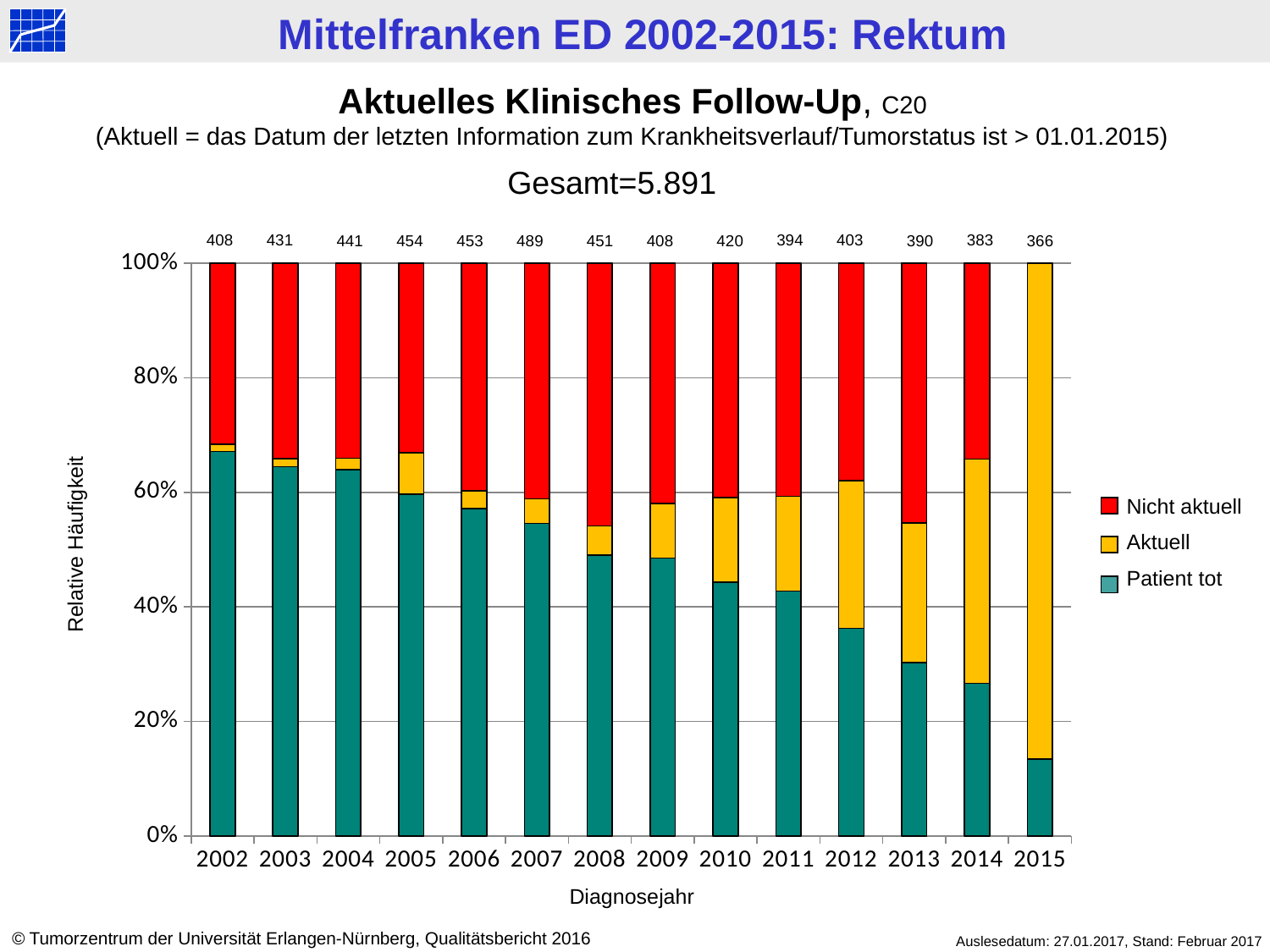
Which diagnosis year has the lowest number printed above its bar? 2015 Which diagnosis year has the highest number printed above its bar? 2007 Is the 'Patient tot' share for 2015 greater or less than 20%? less What number is printed above the bar for 2007? 489 What number is printed above the bar for 2002? 408 Which year has the larger number printed above its bar, 2003 or 2004? 2004 How many series does the legend list? 3 How many diagnosis years are shown on the x axis? 14 Does the 'Patient tot' share rise or fall from 2002 to 2015? fall What number is printed above the bar for 2015? 366 What is the difference between the numbers printed above the bars for 2007 and 2015? 123 Is the 'Patient tot' share for 2002 greater or less than 60%? greater